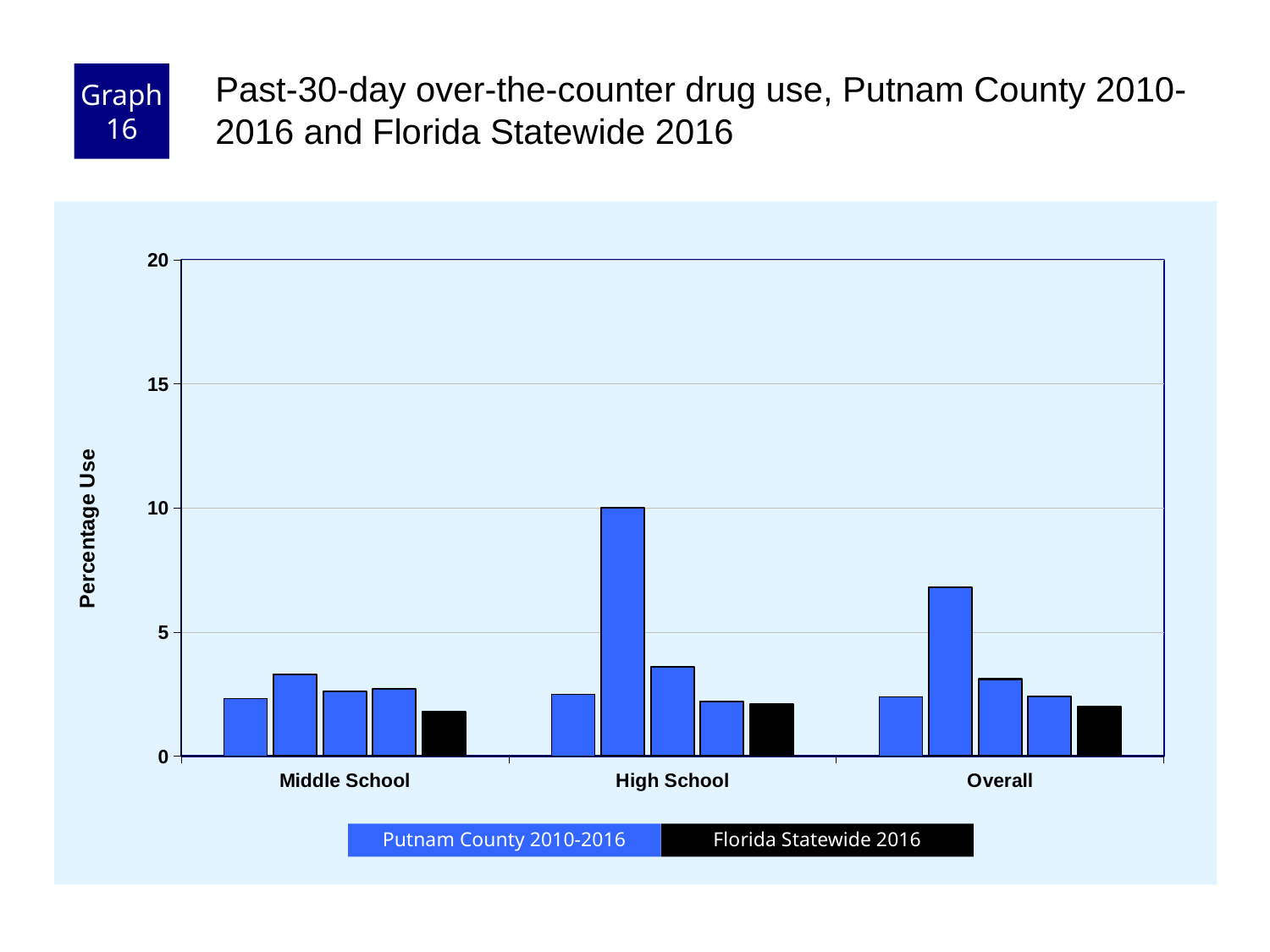
What is the title of the chart's y axis? Percentage Use What colour represents Florida Statewide 2016 in the chart's legend? black What kind of chart is shown on the slide? bar chart How many categories are shown on the x axis of the chart? 3 Are all the Middle School bars greater or less than 5? less Is the tallest Putnam County 2010-2016 bar for High School greater or less than 5? greater For High School, which is larger: the tallest Putnam County 2010-2016 bar or the Florida Statewide 2016 bar? Putnam County 2010-2016 Is the tallest Putnam County 2010-2016 bar for Overall greater or less than 5? greater Which category on the x axis contains the tallest bar in the chart? High School How many series does the chart's legend list? 2